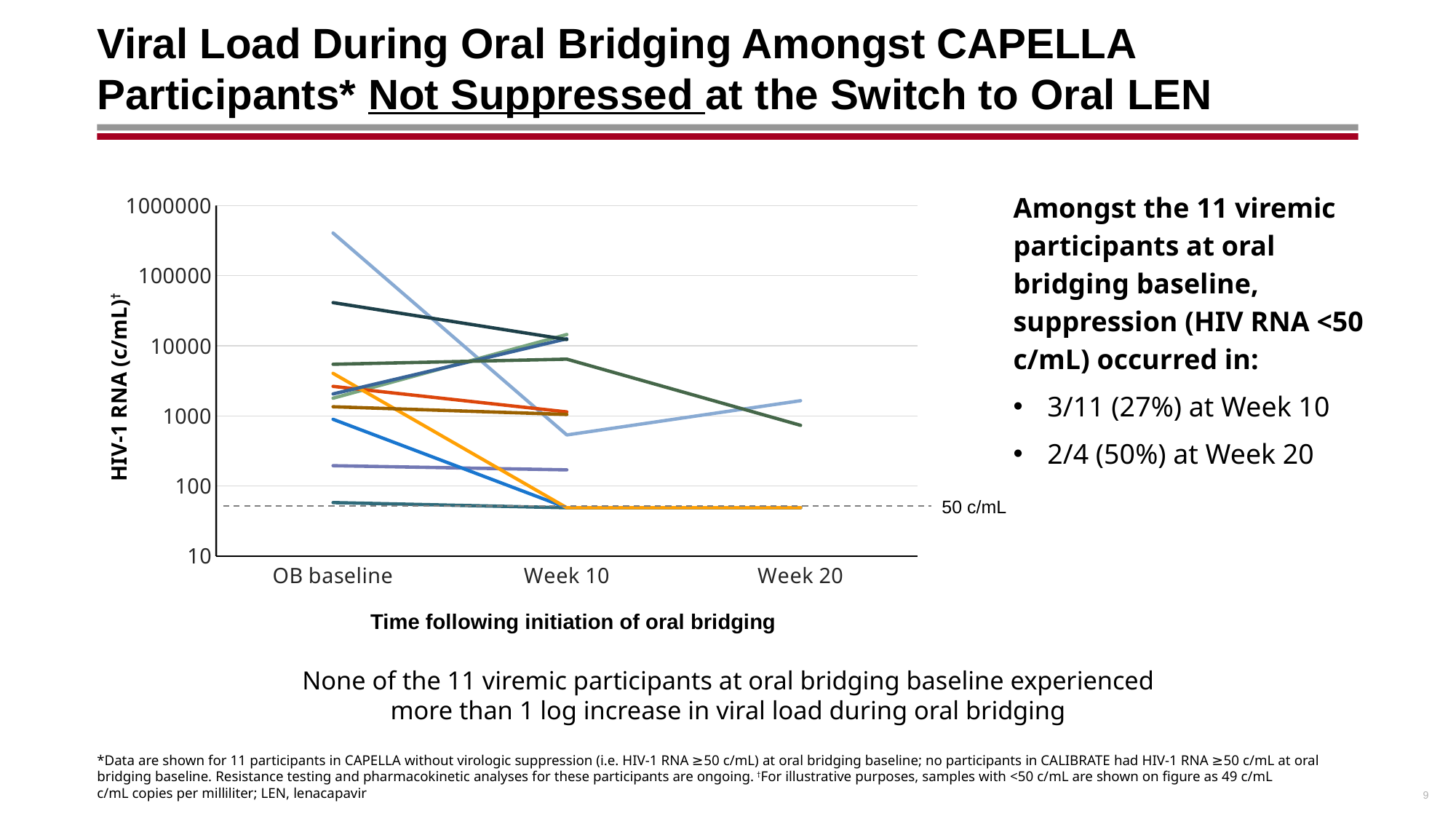
What value does the dashed horizontal reference line on the chart mark? 50 c/mL What kind of chart is shown on the slide? line chart Does the light blue line rise or fall from Week 10 to Week 20? rise Does the light blue line, which starts highest at OB baseline, rise or fall from OB baseline to Week 10? fall Is the highest HIV-1 RNA value at Week 20 greater or less than 1000 c/mL? greater Does the orange line rise or fall from OB baseline to Week 10? fall At which time point is the highest HIV-1 RNA value on the chart observed? OB baseline What is the title of the x axis of the chart? Time following initiation of oral bridging Is the highest HIV-1 RNA value at OB baseline greater or less than 100000 c/mL? greater How many time points are shown on the x axis of the chart? 3 Is the highest HIV-1 RNA value at Week 10 greater or less than 100000 c/mL? less